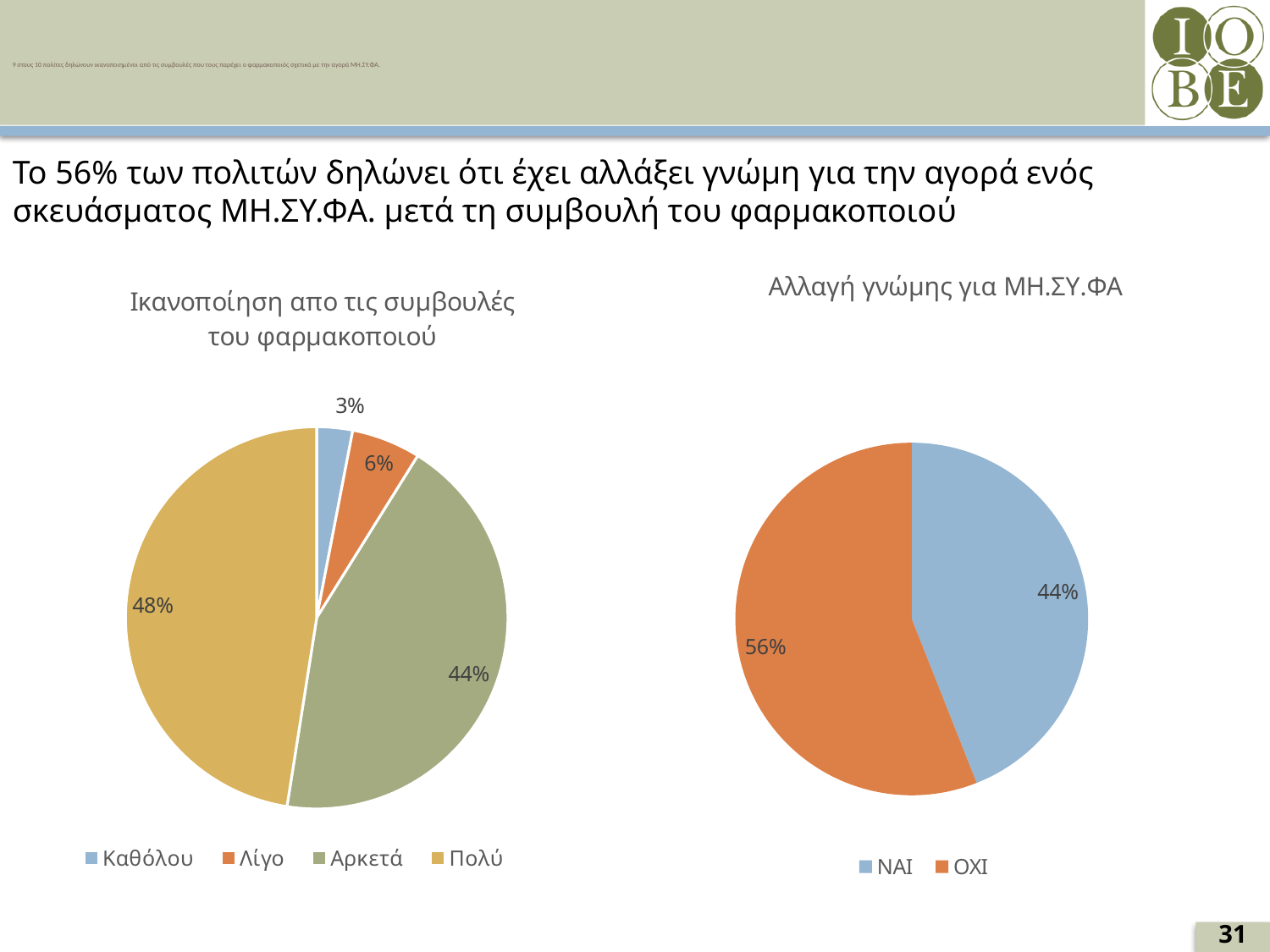
In the pie chart titled 'Αλλαγή γνώμης για ΜΗ.ΣΥ.ΦΑ', which is larger, 'ΝΑΙ' or 'ΟΧΙ'? ΟΧΙ In the pie chart titled 'Ικανοποίηση απο τις συμβουλές του φαρμακοποιού', what is the value for 'Καθόλου'? 3% What type of chart is the chart on the right of the slide? Pie chart In the pie chart titled 'Ικανοποίηση απο τις συμβουλές του φαρμακοποιού', what is the difference between 'Πολύ' and 'Αρκετά'? 4% In the pie chart titled 'Αλλαγή γνώμης για ΜΗ.ΣΥ.ΦΑ', what is the value for 'ΟΧΙ'? 56% In the pie chart titled 'Ικανοποίηση απο τις συμβουλές του φαρμακοποιού', which category has the largest share? Πολύ In the pie chart titled 'Ικανοποίηση απο τις συμβουλές του φαρμακοποιού', what is the value for 'Λίγο'? 6% In the pie chart titled 'Ικανοποίηση απο τις συμβουλές του φαρμακοποιού', what is the value for 'Πολύ'? 48% In the pie chart titled 'Ικανοποίηση απο τις συμβουλές του φαρμακοποιού', which category has the smallest share? Καθόλου In the pie chart titled 'Αλλαγή γνώμης για ΜΗ.ΣΥ.ΦΑ', what is the value for 'ΝΑΙ'? 44% In the pie chart titled 'Ικανοποίηση απο τις συμβουλές του φαρμακοποιού', how many categories are shown? 4 In the pie chart titled 'Αλλαγή γνώμης για ΜΗ.ΣΥ.ΦΑ', what is the difference between 'ΟΧΙ' and 'ΝΑΙ'? 12%